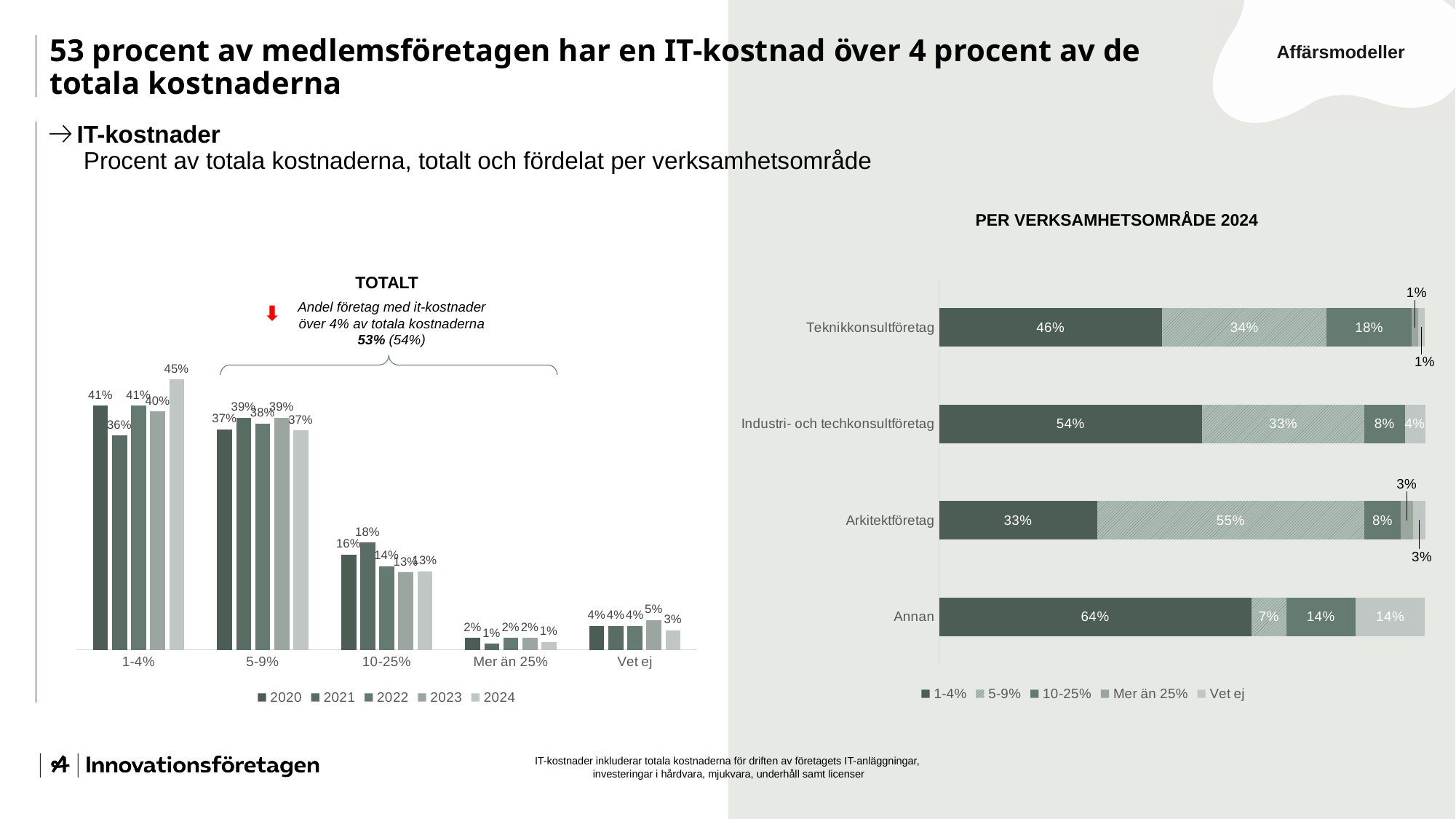
In the PER VERKSAMHETSOMRÅDE 2024 chart, which category has the highest 1-4% share? Annan In the PER VERKSAMHETSOMRÅDE 2024 chart, what is the 5-9% share for Arkitektföretag? 55% In the PER VERKSAMHETSOMRÅDE 2024 chart, what is the 1-4% share for Annan? 64% In the TOTALT chart, what is the value for 2024 in the 1-4% category? 45% In the TOTALT chart, what is the value for 2021 in the 10-25% category? 18% In the TOTALT chart, which year has the highest value in the 1-4% category? 2024 In the TOTALT chart, which year has the lowest value in the 1-4% category? 2021 In the PER VERKSAMHETSOMRÅDE 2024 chart, is the 10-25% share larger for Teknikkonsultföretag or for Arkitektföretag? Teknikkonsultföretag What kind of chart is the PER VERKSAMHETSOMRÅDE 2024 chart? Stacked bar chart In the TOTALT chart, how many categories are shown on the x axis? 5 In the TOTALT chart, what is the difference between the 2020 and 2024 values in the 10-25% category? 3% In the TOTALT chart, how many series does the legend list? 5